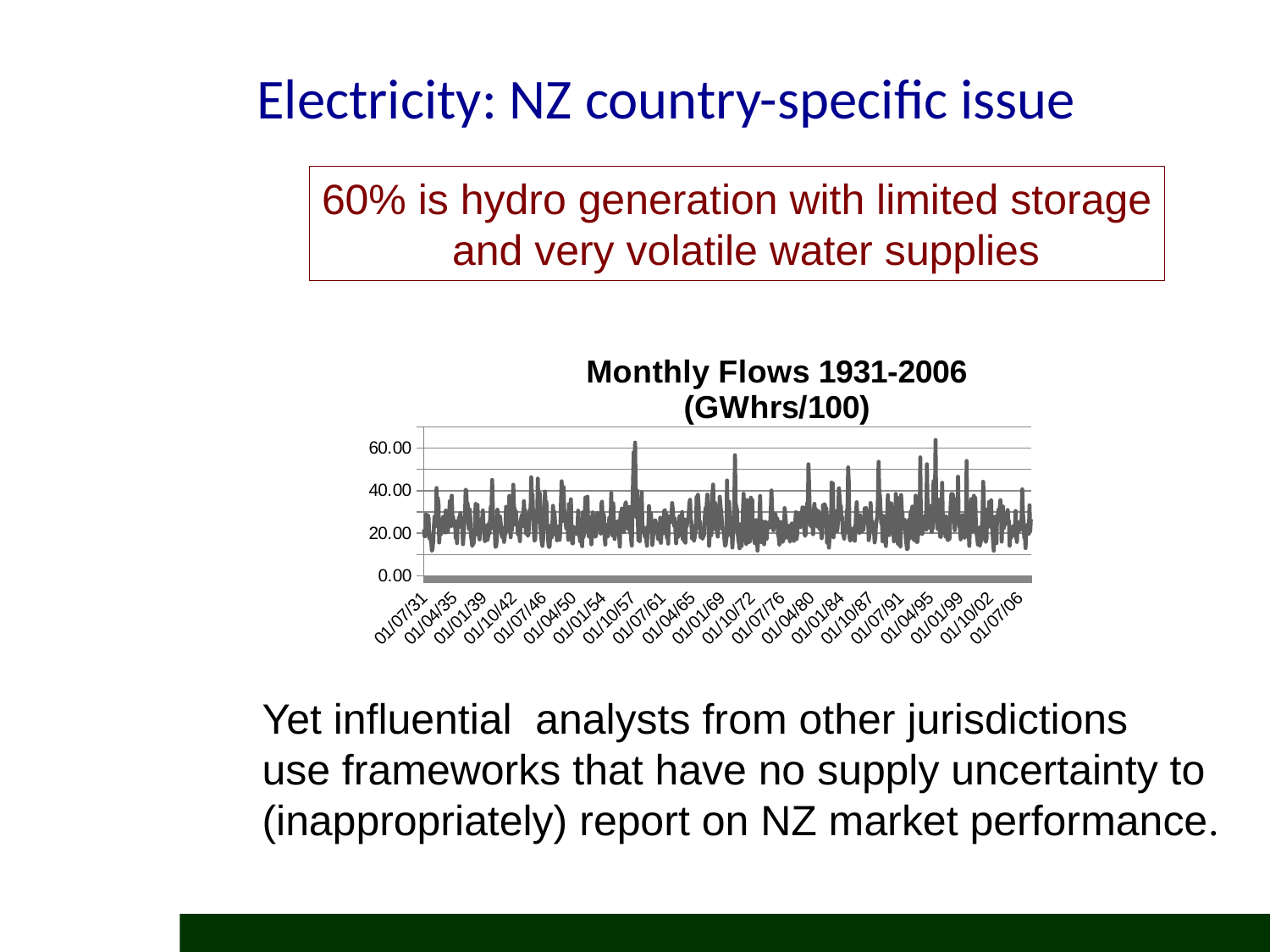
What is the title of the chart? Monthly Flows 1931-2006 (GWhrs/100) Does the monthly flows series show a steady rise, a steady fall, or fluctuation with no clear trend from 1931 to 2006? fluctuation with no clear trend What is the first date label on the chart's x axis? 01/07/31 Is the lowest value of the monthly flows series greater or less than 20.00? less What kind of chart is shown on the slide? line chart Is the highest value of the monthly flows series greater or less than 40.00? greater How many date labels are shown along the chart's x axis? 21